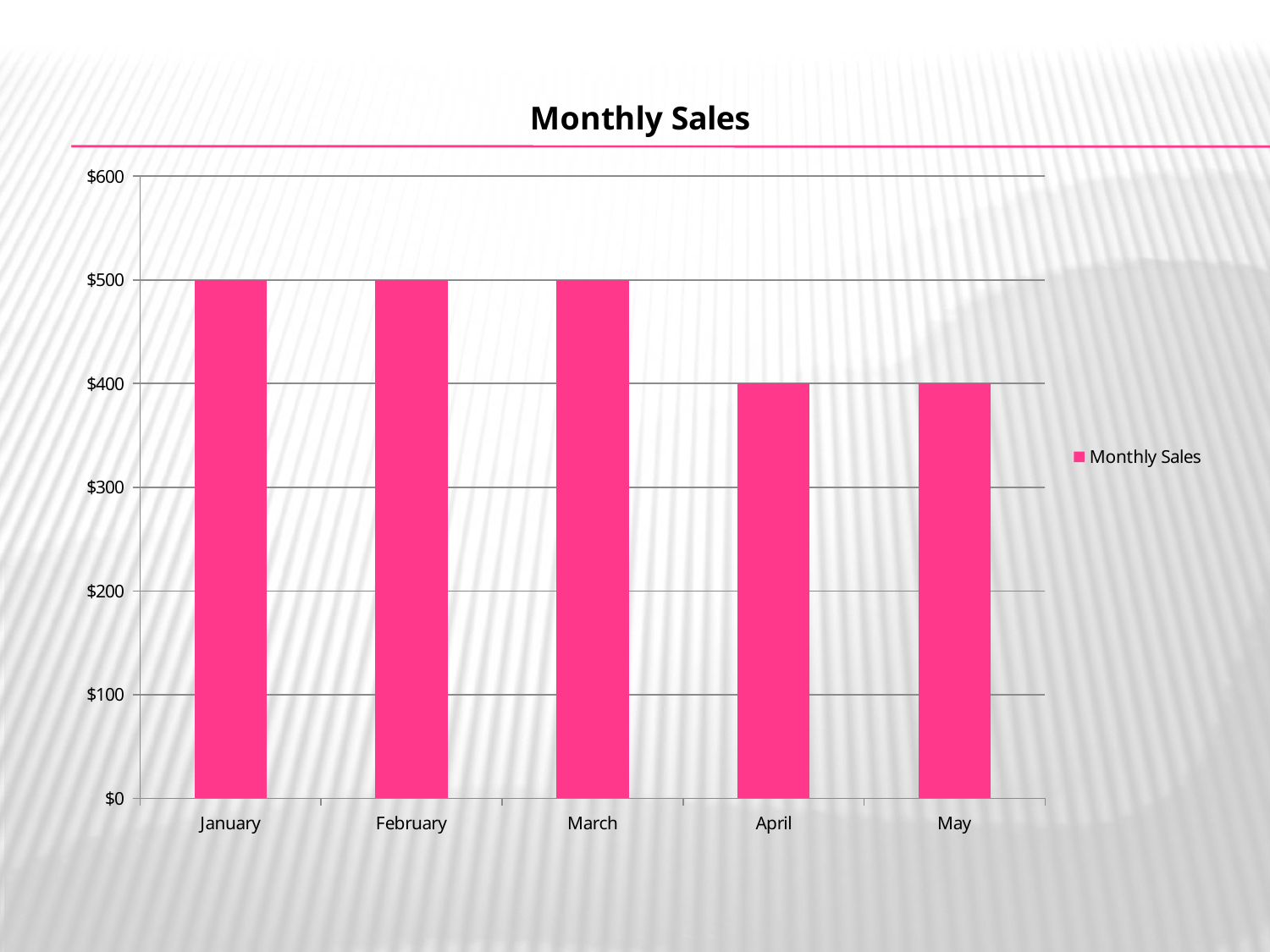
What is the value for January? $500 How many series does the legend list? 1 Which is larger, the value for February or the value for May? February What kind of chart is shown? bar chart How many months are shown on the x axis? 5 Is the value for March greater or less than $400? greater What is the value for April? $400 What is the value for May? $400 What is the title of the chart? Monthly Sales Is the value for April greater or less than $500? less What is the value for March? $500 What is the difference between the value for January and the value for April? $100